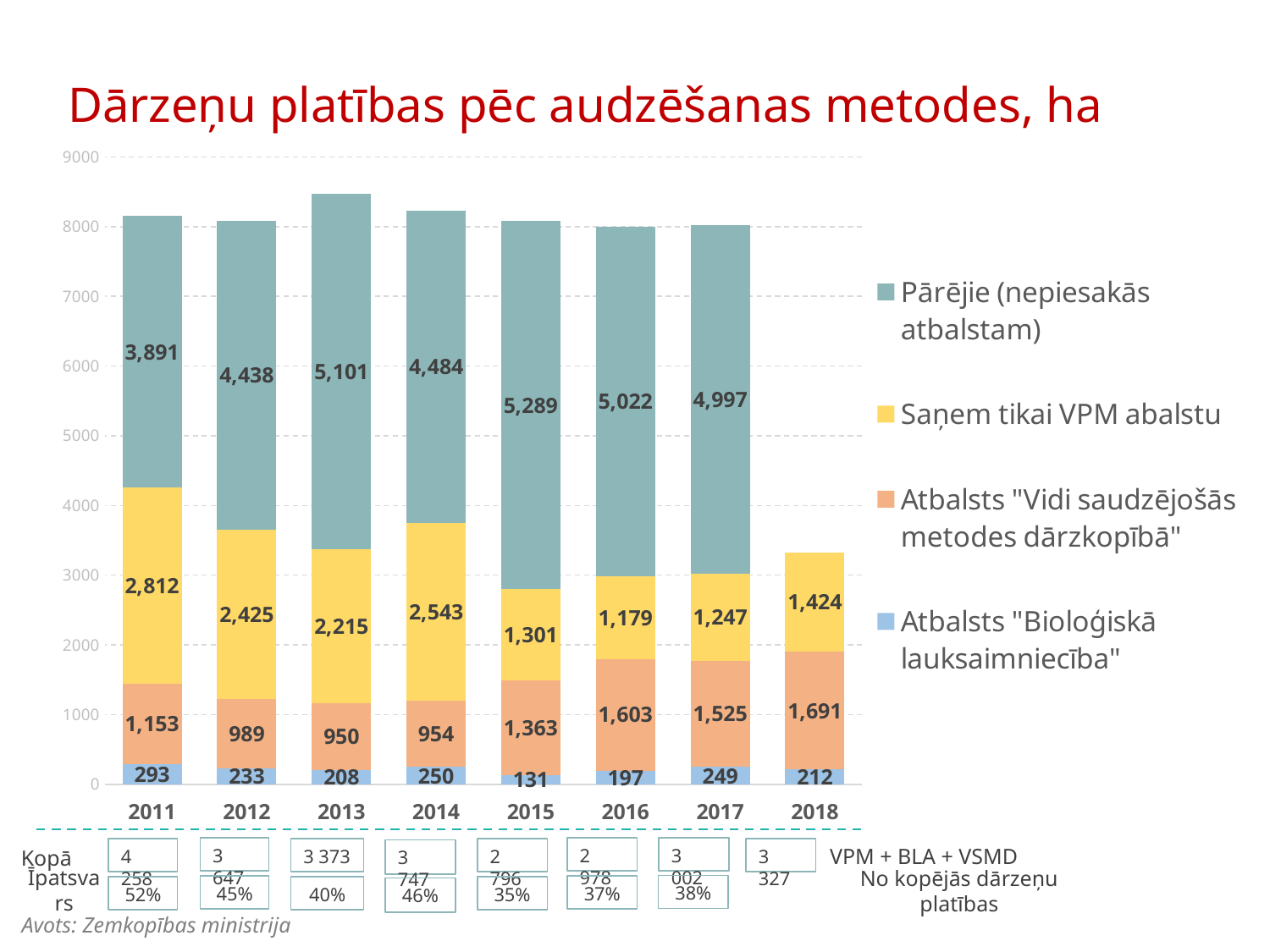
What is the difference between the "Atbalsts "Vidi saudzējošās metodes dārzkopībā"" values in 2018 and 2011? 538 What is the value for "Pārējie (nepiesakās atbalstam)" in 2013? 5,101 What is the value for "Atbalsts "Bioloģiskā lauksaimniecība"" in 2015? 131 In which year is the "Pārējie (nepiesakās atbalstam)" value highest? 2015 How many years are shown on the x axis? 8 How many series does the legend list? 4 What kind of chart is shown on the slide? Stacked bar chart What is the total of the stacked bar for 2018? 3,327 What is the value for "Saņem tikai VPM abalstu" in 2018? 1,424 In which year is the "Atbalsts "Bioloģiskā lauksaimniecība"" value lowest? 2015 What is the value for "Atbalsts "Vidi saudzējošās metodes dārzkopībā"" in 2016? 1,603 Which year has the larger "Saņem tikai VPM abalstu" value, 2012 or 2014? 2014